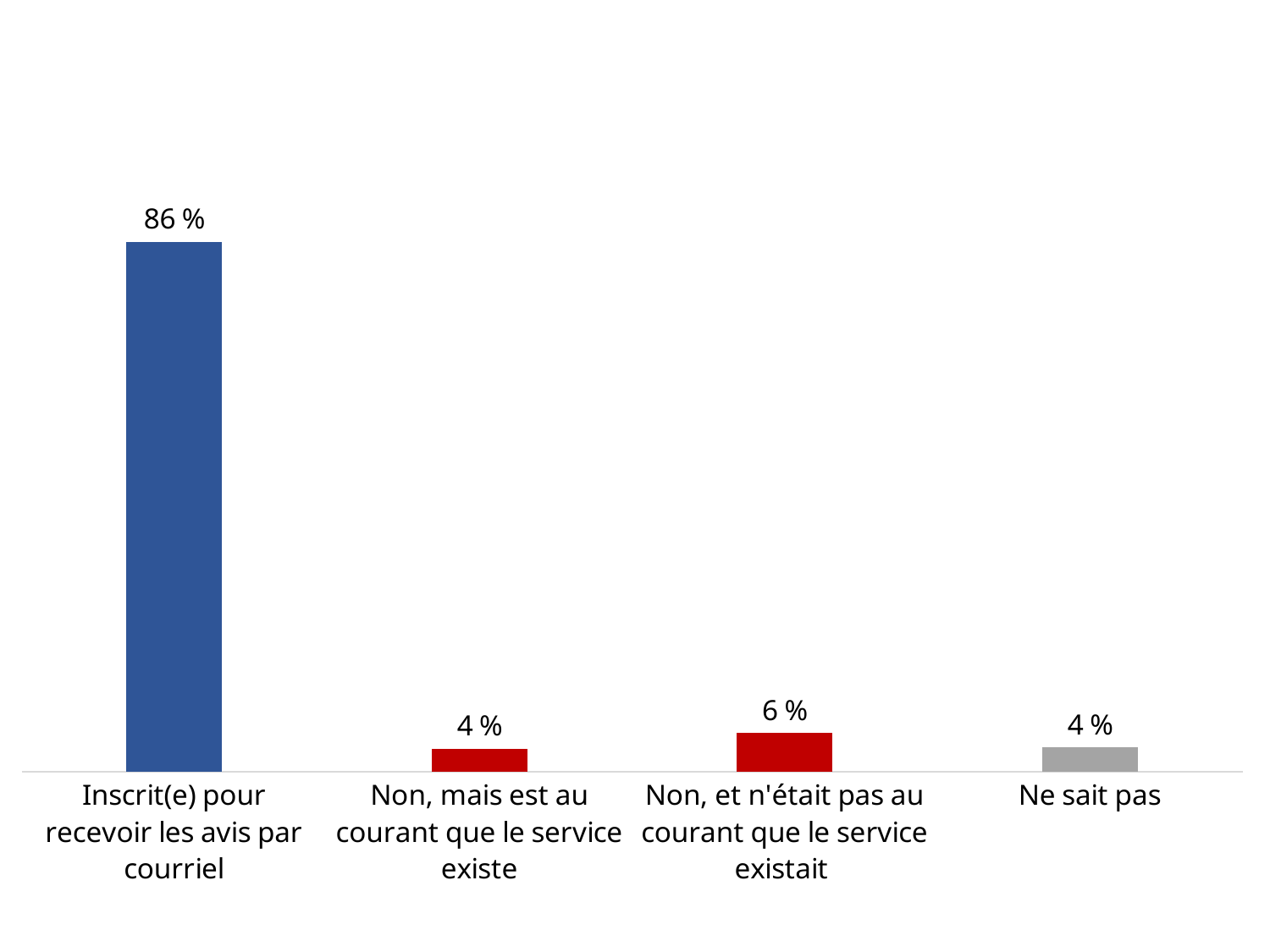
What is the value for "Non, et n'était pas au courant que le service existait"? 6 % What colour is the bar for "Inscrit(e) pour recevoir les avis par courriel"? Blue What colour is the bar for "Ne sait pas"? Grey What is the difference between the value for "Non, et n'était pas au courant que le service existait" and the value for "Ne sait pas"? 2 % Which is larger: the value for "Non, et n'était pas au courant que le service existait" or the value for "Non, mais est au courant que le service existe"? Non, et n'était pas au courant que le service existait What kind of chart is shown on the slide? Bar chart Which category has the highest value? Inscrit(e) pour recevoir les avis par courriel What is the value for "Non, mais est au courant que le service existe"? 4 % What is the value for "Ne sait pas"? 4 % How many categories are shown in the chart? 4 What is the value for "Inscrit(e) pour recevoir les avis par courriel"? 86 % What is the difference between the value for "Inscrit(e) pour recevoir les avis par courriel" and the value for "Non, et n'était pas au courant que le service existait"? 80 %